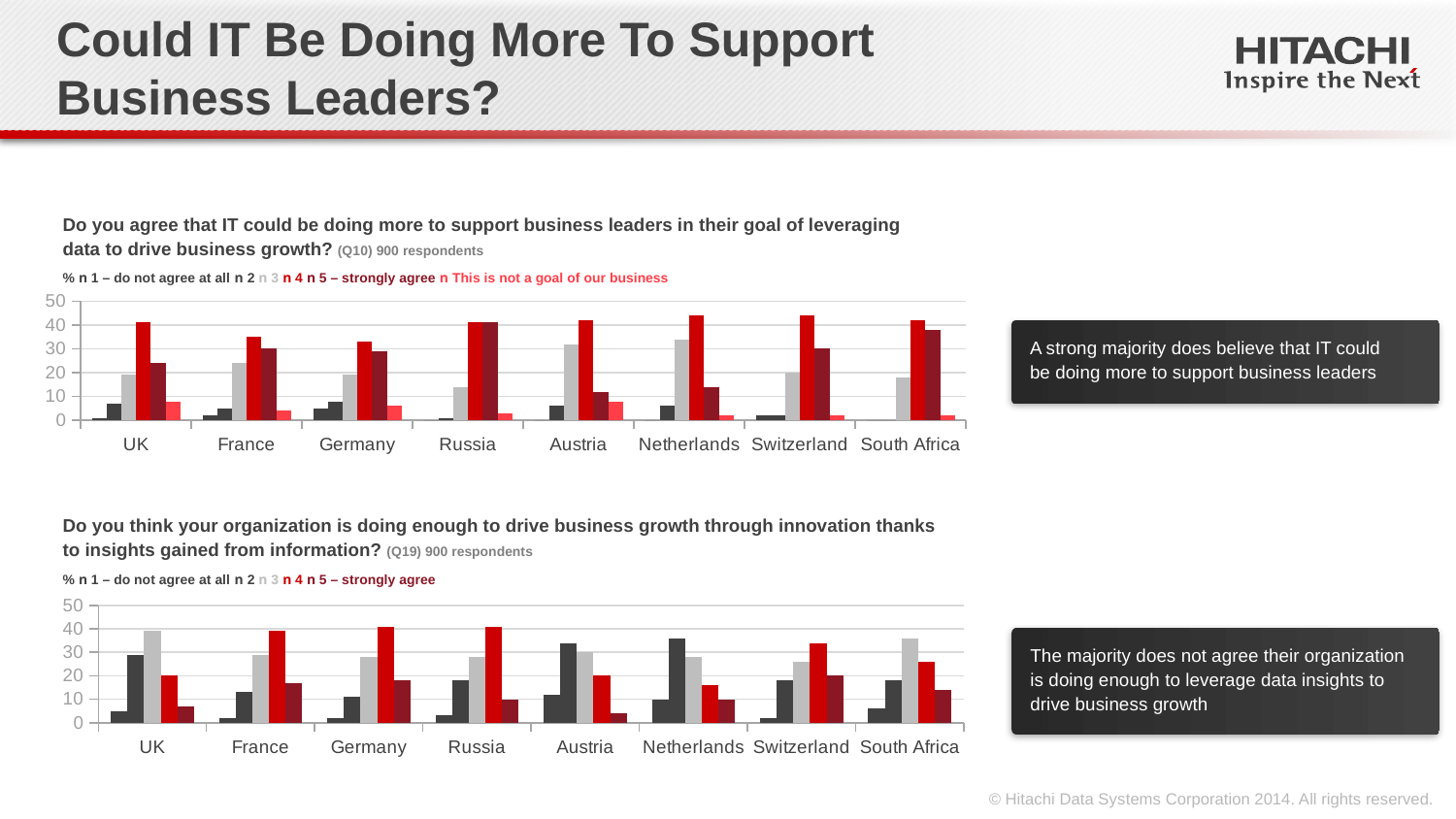
In the top chart (Q10), is the value of the '4' series for Netherlands greater or less than 40? greater How many countries are shown on the x axis of the bottom chart (Q19)? 8 In the bottom chart (Q19), is the value of the '4' series for UK greater or less than 30? less In the bottom chart (Q19), which country has the lowest value for the '4' series? Netherlands In the bottom chart (Q19), is the value of the '4' series for Germany greater or less than 30? greater Which legend entry appears in the top chart (Q10) but not in the bottom chart (Q19)? This is not a goal of our business What kind of chart is the top chart (Q10)? bar chart How many series does the legend of the top chart (Q10) list? 6 How many series does the legend of the bottom chart (Q19) list? 5 In the bottom chart (Q19), for UK, which is larger: the '3' series or the '4' series? 3